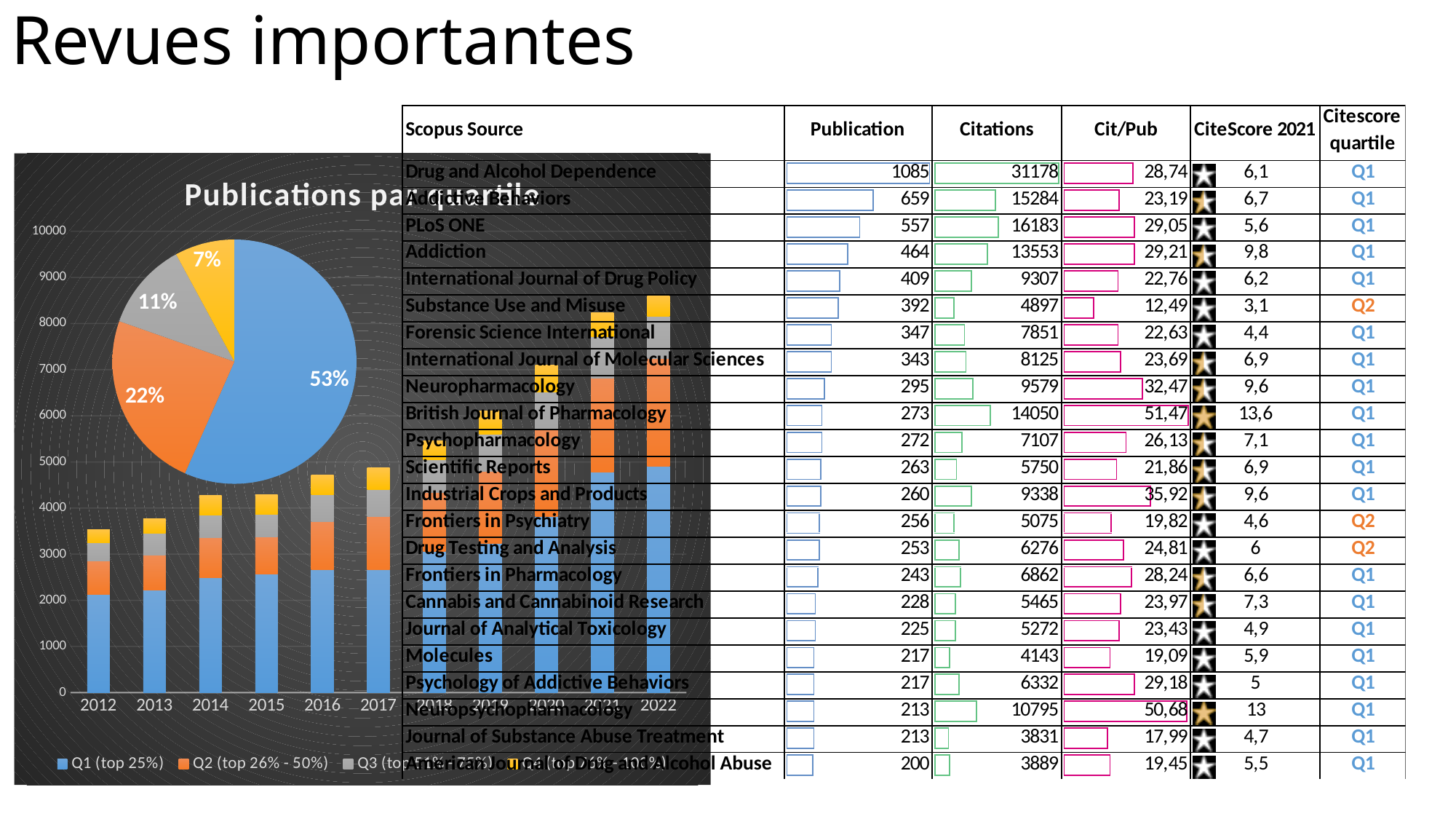
In the pie chart, how many percentage points larger is the Q1 slice than the Q2 slice? 31 Which quartile has the smallest share in the pie chart? Q4 In the pie chart, what percentage is shown for the grey slice? 11% What is the title of the chart on the left of the slide? Publications par quartile Which quartile has the largest share in the pie chart? Q1 (top 25%) In the pie chart, what percentage is shown for the largest slice? 53% Is the total height of the stacked bar for 2017 greater or less than 4000? greater In the pie chart, what percentage is shown for the orange slice? 22% In the pie chart, which slice is larger: the grey slice or the yellow slice? the grey slice In the pie chart, what percentage is shown for the yellow slice? 7% What kind of chart shows the publications by year at the bottom of the left chart? stacked bar chart Do the stacked bars generally rise or fall from 2012 to 2017? rise